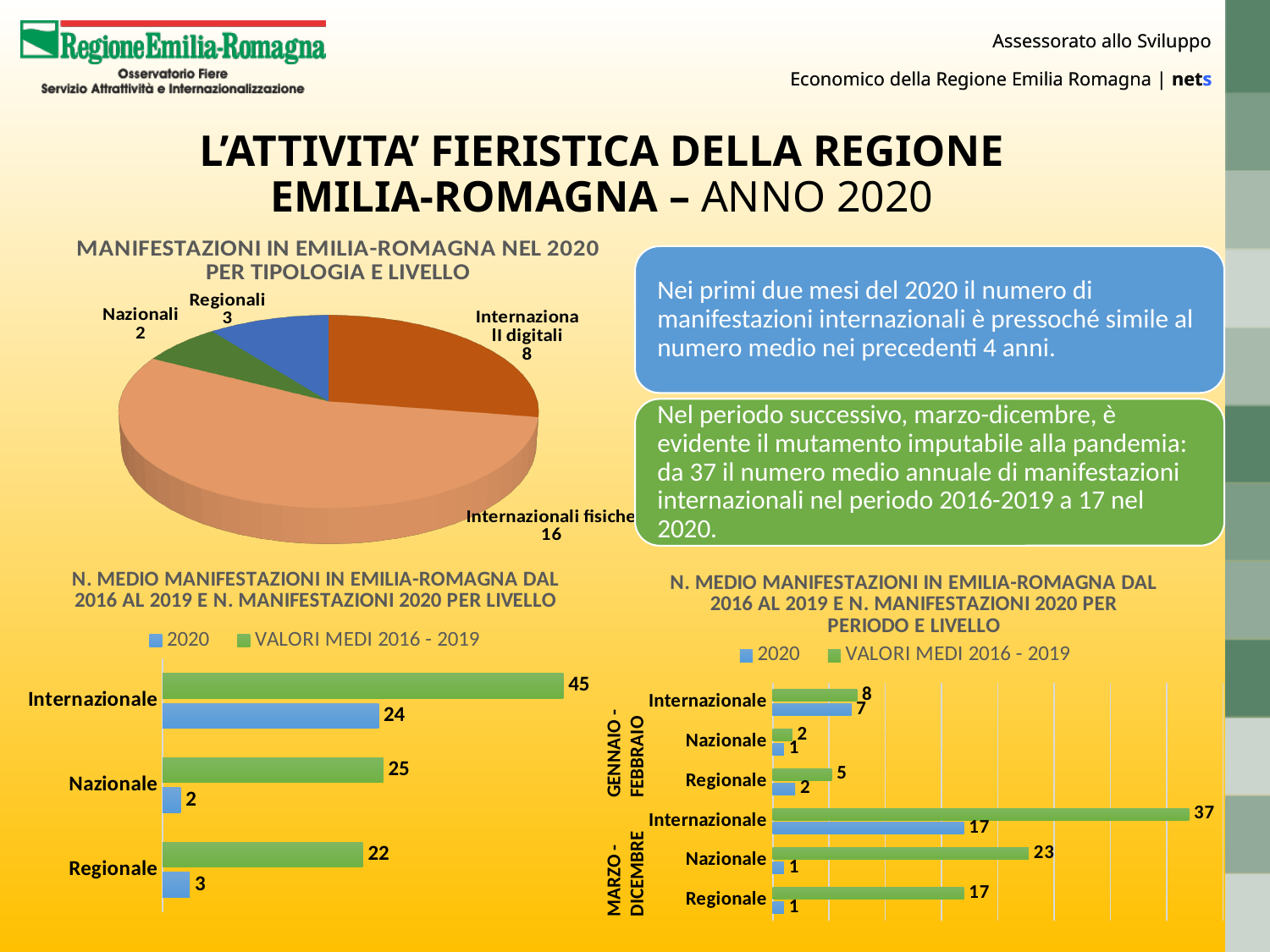
In the bottom-right bar chart 'N. medio manifestazioni ... per periodo e livello', what is the 'Valori medi 2016 - 2019' value for Internazionale in the Marzo - Dicembre period? 37 In the bottom-left bar chart 'N. medio manifestazioni ... per livello', how many series does the legend list? 2 In the bottom-left bar chart 'N. medio manifestazioni ... per livello', what is the 2020 value for Internazionale? 24 In the bottom-left bar chart 'N. medio manifestazioni ... per livello', which category has the highest 'Valori medi 2016 - 2019' value? Internazionale In the pie chart 'Manifestazioni in Emilia-Romagna nel 2020 per tipologia e livello', how many categories are shown? 4 In the bottom-right bar chart 'N. medio manifestazioni ... per periodo e livello', which is larger for Regionale in Gennaio - Febbraio: the 2020 value or the 'Valori medi 2016 - 2019' value? Valori medi 2016 - 2019 In the pie chart 'Manifestazioni in Emilia-Romagna nel 2020 per tipologia e livello', which category has the smallest slice? Nazionali In the pie chart 'Manifestazioni in Emilia-Romagna nel 2020 per tipologia e livello', what share of the total do the 'Internazionali digitali' events represent? 8 of 29 In the pie chart 'Manifestazioni in Emilia-Romagna nel 2020 per tipologia e livello', how many events are labelled 'Internazionali fisiche'? 16 In the bottom-left bar chart 'N. medio manifestazioni ... per livello', what is the difference between the 'Valori medi 2016 - 2019' value and the 2020 value for Nazionale? 23 In the bottom-right bar chart 'N. medio manifestazioni ... per periodo e livello', what is the 2020 value for Nazionale in the Marzo - Dicembre period? 1 What kind of chart is the bottom-left chart 'N. medio manifestazioni ... per livello'? Bar chart